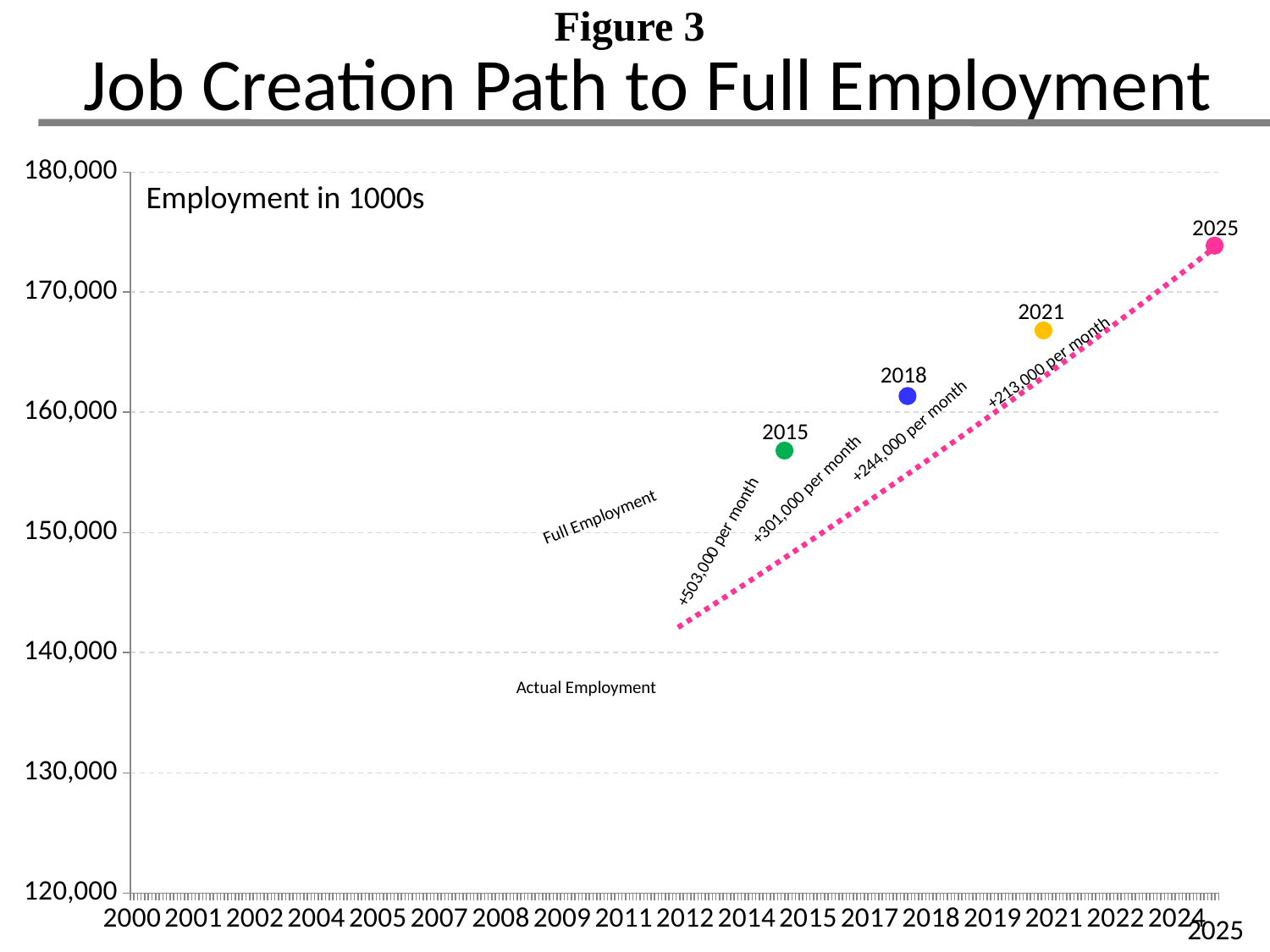
Which labeled year has the lowest employment value on the chart? 2015 Is the employment value for 2015 greater or less than 150,000? greater What monthly job creation rate is annotated on the last segment of the dotted line, leading to the 2025 point? +213,000 per month Which labeled year has the highest employment value on the chart? 2025 What is the title of the chart on the slide? Job Creation Path to Full Employment Is the employment value for 2021 greater or less than 170,000? less How many labeled year points are plotted on the chart? 4 Is the employment value for 2025 greater or less than 170,000? greater What monthly job creation rate is annotated on the first segment of the dotted line, nearest the 2015 point? +503,000 per month What label describes the units on the vertical axis of the chart? Employment in 1000s Which has the higher employment value, the 2018 point or the 2021 point? 2021 Do the plotted employment values rise or fall from 2015 to 2025? rise